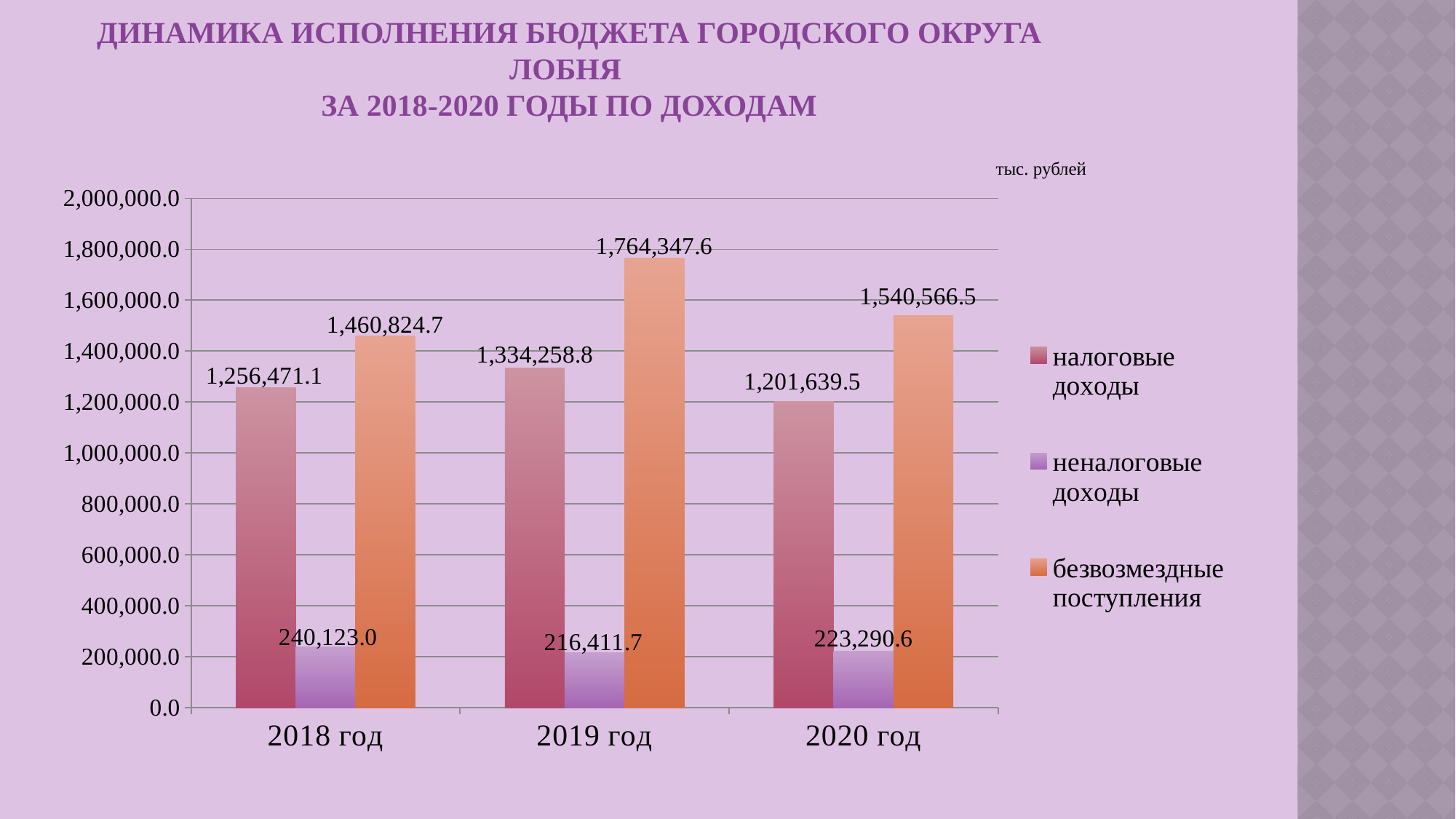
Which is larger in 2020 год: налоговые доходы or безвозмездные поступления? безвозмездные поступления How many series does the legend list? 3 In which year is безвозмездные поступления the highest? 2019 год In which year is неналоговые доходы the lowest? 2019 год What is the value of безвозмездные поступления for 2019 год? 1,764,347.6 How many years are shown on the x axis? 3 Is the value of неналоговые доходы for 2020 год greater or less than 400,000.0? less What kind of chart is shown on the slide? bar chart What is the difference between налоговые доходы in 2019 год and in 2020 год? 132,619.3 What is the value of налоговые доходы for 2018 год? 1,256,471.1 What is the difference between безвозмездные поступления in 2019 год and in 2018 год? 303,522.9 What is the value of неналоговые доходы for 2020 год? 223,290.6